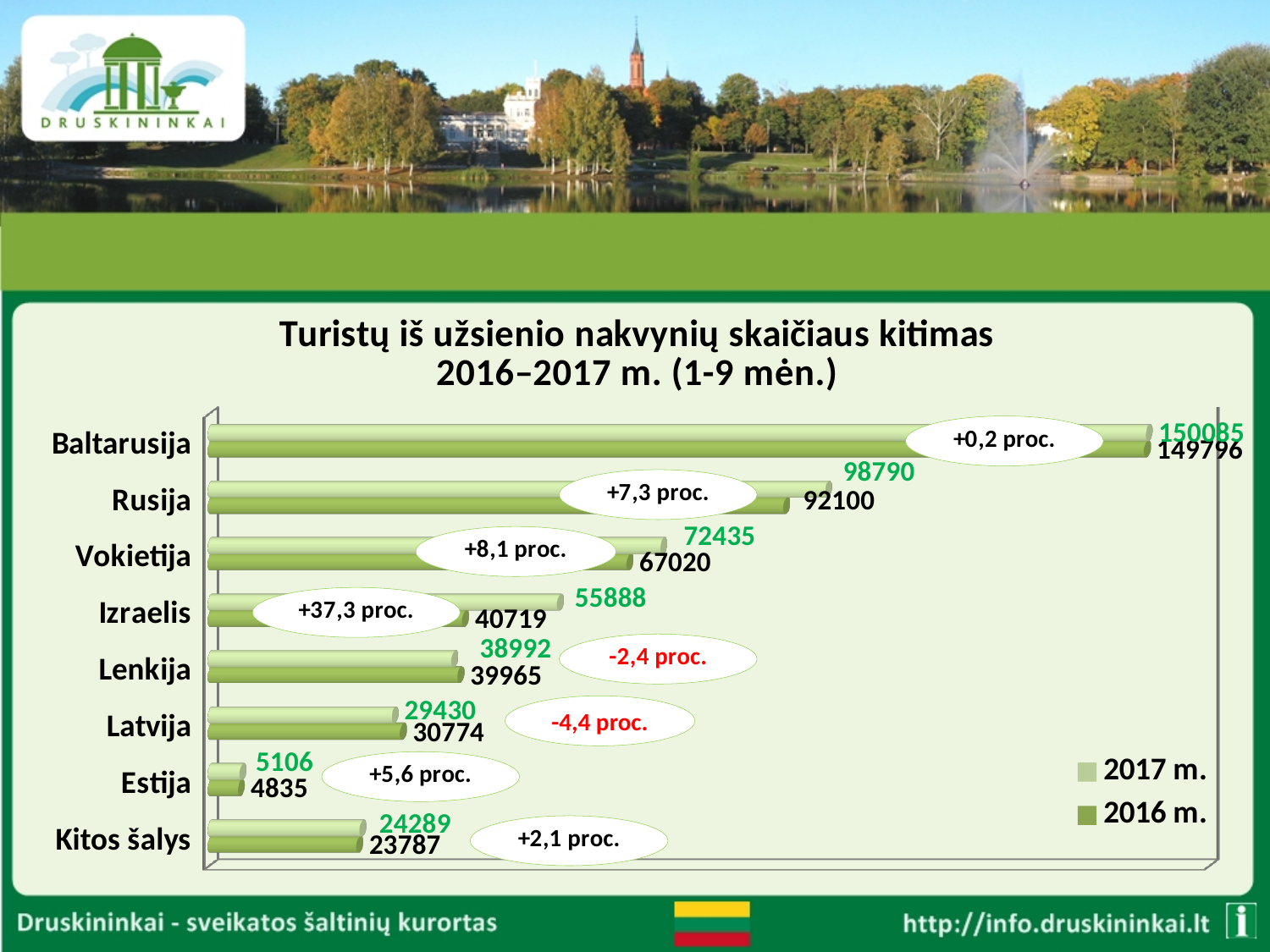
What is the 2016 m. value for Vokietija? 67020 Which category has the highest 2017 m. value? Baltarusija Which legend entry is shown in the lighter green colour? 2017 m. Which category has the lowest 2016 m. value? Estija What is the 2017 m. value for Izraelis? 55888 What type of chart is shown on the slide? bar chart What is the 2017 m. value for Rusija? 98790 Which is larger for Lenkija, the 2017 m. value or the 2016 m. value? 2016 m. How many series does the legend list? 2 What is the difference between the 2017 m. and 2016 m. values for Izraelis? 15169 How many categories (countries/groups) are shown on the chart? 8 What percentage change is shown for Latvija? -4,4 proc.